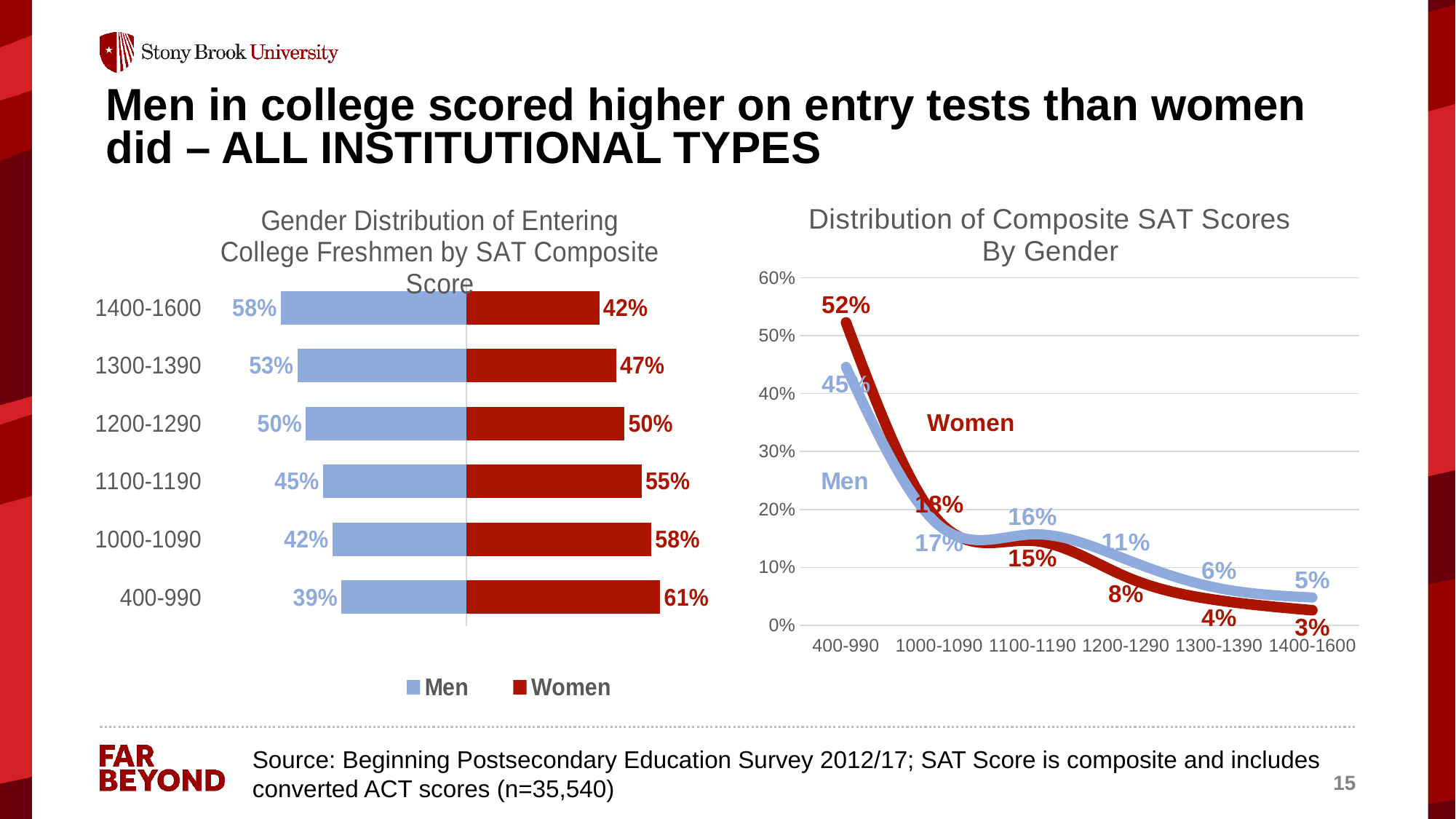
What type of chart is the left chart, Gender Distribution of Entering College Freshmen by SAT Composite Score? Bar chart In the right chart, Distribution of Composite SAT Scores By Gender, do the values for women rise or fall as the score range increases? Fall In the right chart, Distribution of Composite SAT Scores By Gender, what is the value for men in the 1200-1290 range? 11% In the left chart, Gender Distribution of Entering College Freshmen by SAT Composite Score, what percentage of the 1400-1600 group are men? 58% In the right chart, Distribution of Composite SAT Scores By Gender, what is the value for women in the 400-990 range? 52% What type of chart is the right chart, Distribution of Composite SAT Scores By Gender? Line chart In the right chart, Distribution of Composite SAT Scores By Gender, which is larger in the 1100-1190 range, the men's value or the women's value? Men In the left chart, Gender Distribution of Entering College Freshmen by SAT Composite Score, how many score ranges are shown? 6 In the left chart, Gender Distribution of Entering College Freshmen by SAT Composite Score, which score range has the highest share of women? 400-990 In the left chart, Gender Distribution of Entering College Freshmen by SAT Composite Score, what percentage of the 400-990 group are women? 61% In the left chart, Gender Distribution of Entering College Freshmen by SAT Composite Score, what is the difference between the women's and men's shares in the 1000-1090 group? 16% In the left chart, Gender Distribution of Entering College Freshmen by SAT Composite Score, which score range has the lowest share of men? 400-990